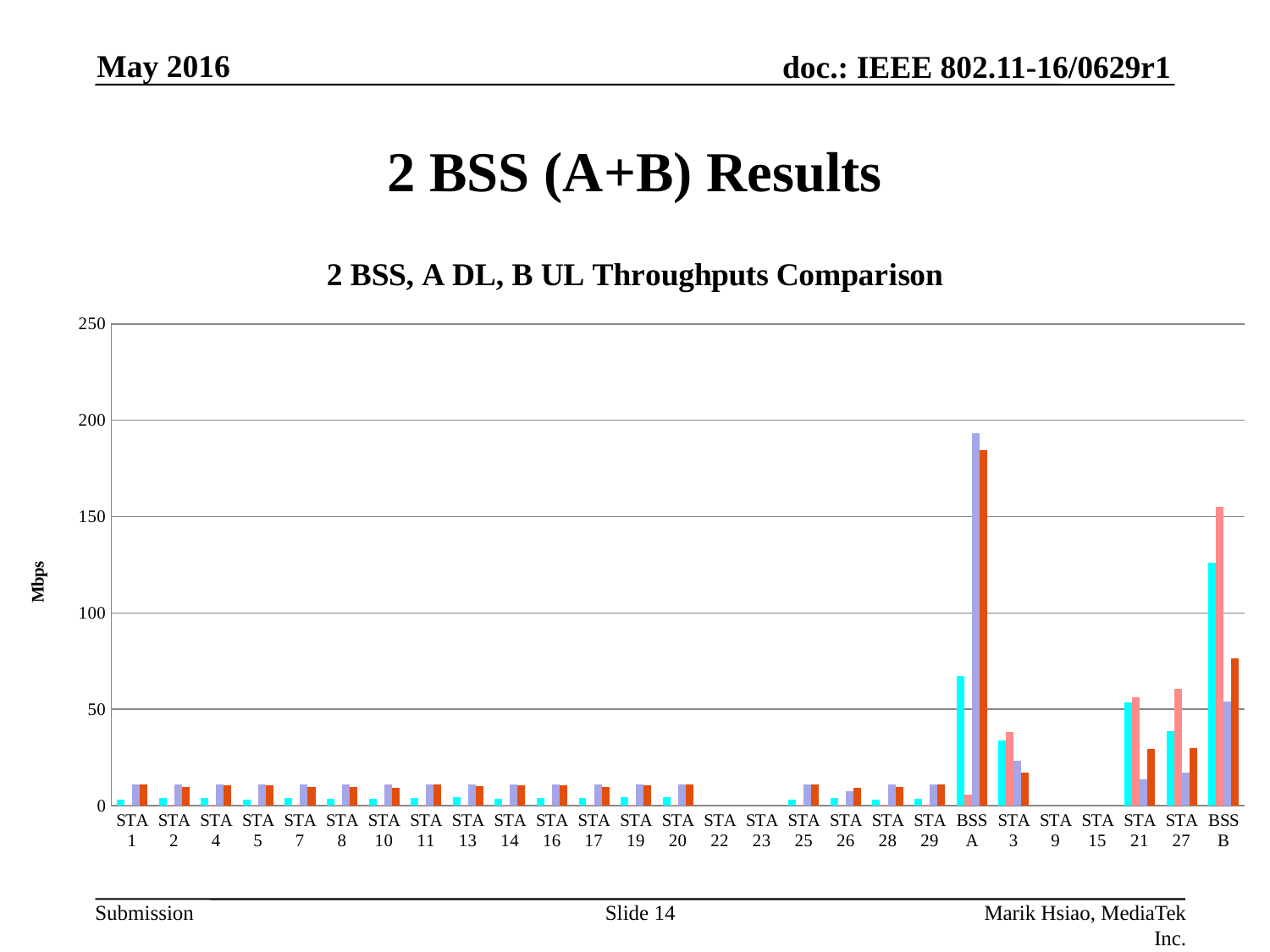
Is the highest value for STA 1 greater or less than 50? less What is the highest tick value shown on the vertical axis? 250 Is the highest value for BSS A greater or less than 150? greater What kind of chart is shown on the slide? bar chart What is the title of the chart? 2 BSS, A DL, B UL Throughputs Comparison Which has the taller maximum bar, BSS A or BSS B? BSS A How many categories are shown along the x axis of the chart? 27 What is the label on the vertical axis of the chart? Mbps Is the highest value for STA 3 greater or less than 50? less Which category has the tallest bar in the chart? BSS A Which has the taller maximum bar, STA 21 or STA 2? STA 21